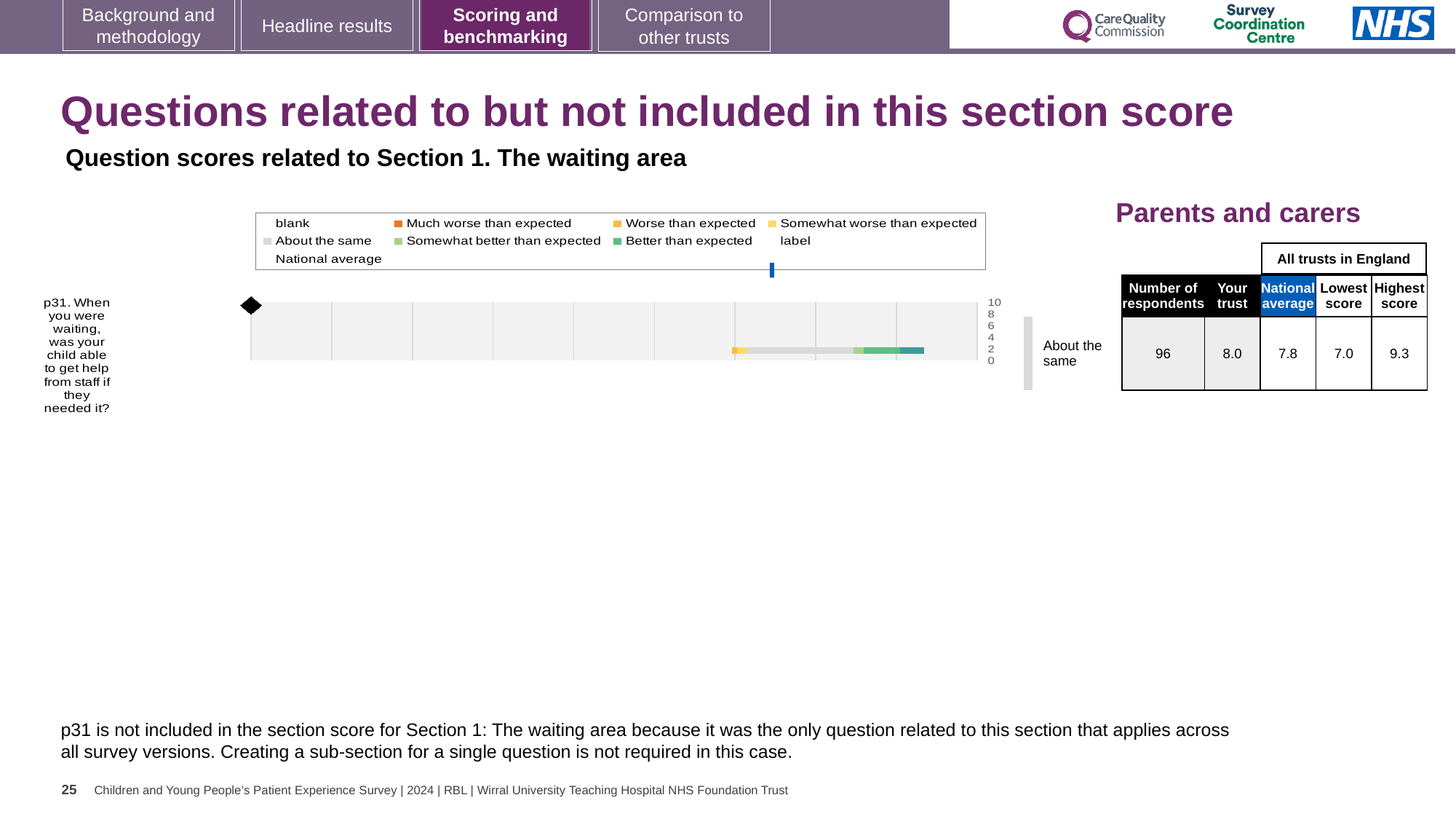
According to the table beside the chart, what is the 'Your trust' score for p31? 8.0 What is the highest tick value shown on the chart's axis? 10 Is the 'Your trust' score for p31 higher or lower than the national average? higher Which question is plotted in the chart? p31. When you were waiting, was your child able to get help from staff if they needed it? According to the table beside the chart, what is the highest score among all trusts in England for p31? 9.3 What benchmark category label is shown next to the bar for p31? About the same What is the difference between the highest score and the lowest score for p31 in the table? 2.3 How many questions are plotted in the chart? 1 According to the table beside the chart, what is the lowest score among all trusts in England for p31? 7.0 What kind of chart is shown on the slide? bar chart According to the table beside the chart, what is the national average score for p31? 7.8 How many respondents answered p31 according to the table? 96